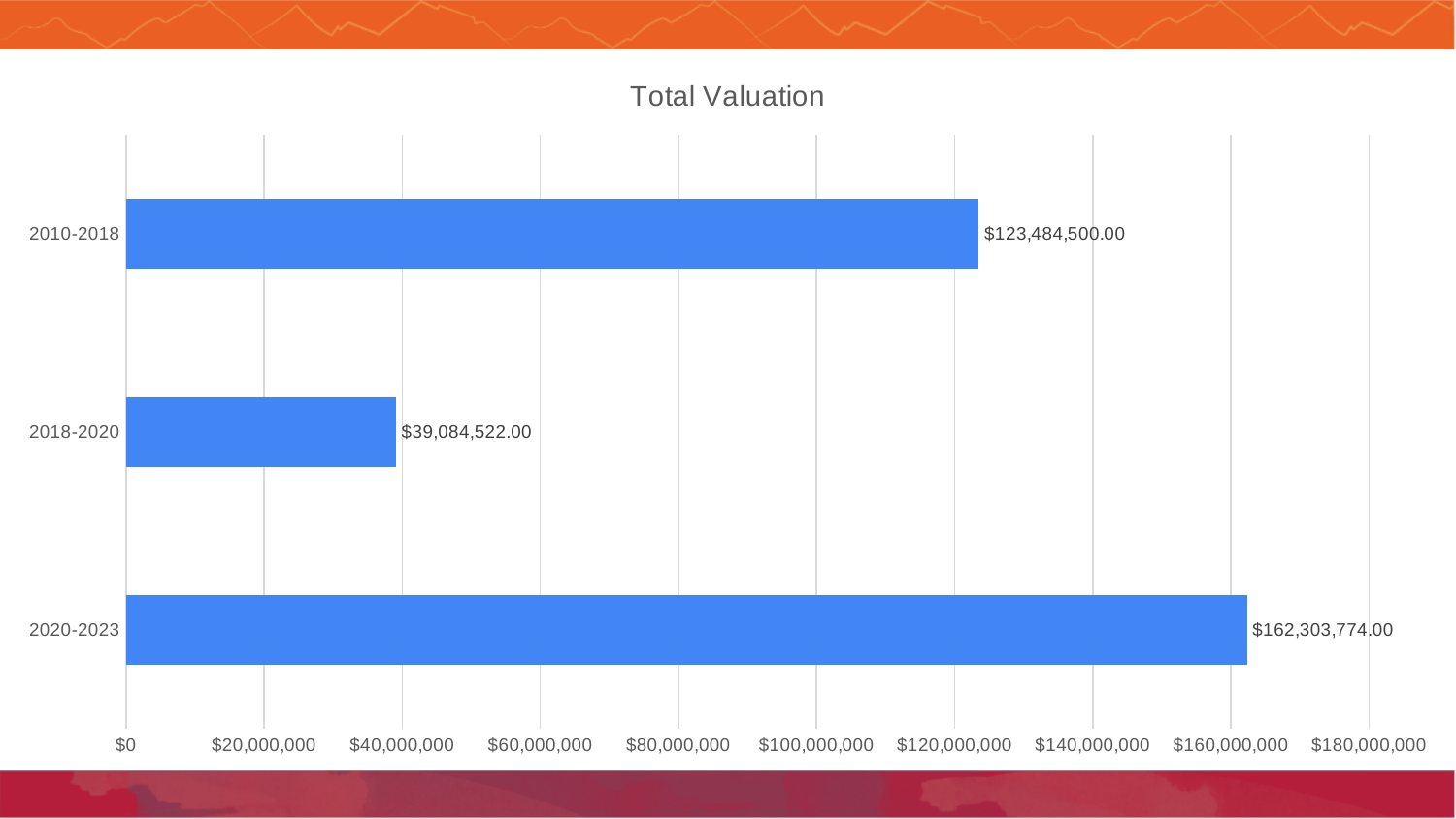
What is the total valuation for 2010-2018? $123,484,500.00 How many periods are shown in the chart? 3 What is the difference in total valuation between 2020-2023 and 2010-2018? $38,819,274.00 Is the total valuation for 2020-2023 greater or less than $160,000,000? greater What is the title of the chart? Total Valuation What is the total valuation for 2020-2023? $162,303,774.00 What is the total valuation for 2018-2020? $39,084,522.00 Which period has a larger total valuation, 2010-2018 or 2018-2020? 2010-2018 Which period has the highest total valuation? 2020-2023 What is the difference in total valuation between 2010-2018 and 2018-2020? $84,399,978.00 What kind of chart is shown on the slide? bar chart Which period has the lowest total valuation? 2018-2020